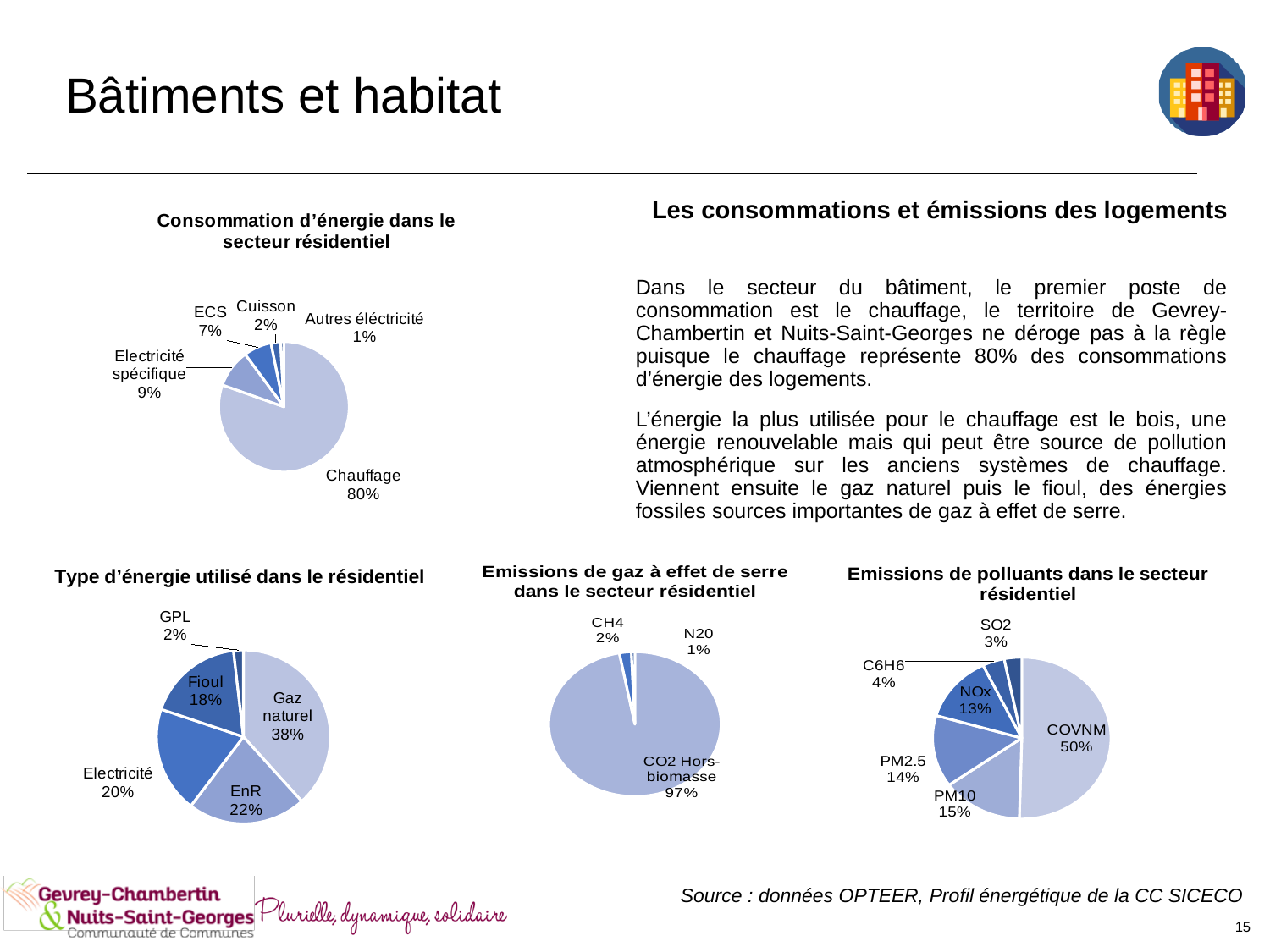
In the chart 'Consommation d'énergie dans le secteur résidentiel', how many slices does the pie have? 5 In the chart 'Emissions de gaz à effet de serre dans le secteur résidentiel', how many categories are shown? 3 In the chart 'Emissions de gaz à effet de serre dans le secteur résidentiel', what share does CO2 Hors-biomasse represent? 97% What kind of chart is 'Emissions de gaz à effet de serre dans le secteur résidentiel'? Pie chart In the chart 'Emissions de polluants dans le secteur résidentiel', which pollutant has the largest share? COVNM In the chart 'Type d'énergie utilisé dans le résidentiel', which energy type has the largest share? Gaz naturel In the chart 'Type d'énergie utilisé dans le résidentiel', what share does Gaz naturel represent? 38% In the chart 'Type d'énergie utilisé dans le résidentiel', what is the difference between the shares of EnR and Fioul? 4% In the chart 'Consommation d'énergie dans le secteur résidentiel', which category has the smallest share? Autres éléctricité In the chart 'Consommation d'énergie dans le secteur résidentiel', what share does Chauffage represent? 80% In the chart 'Type d'énergie utilisé dans le résidentiel', which is larger, Electricité or Fioul? Electricité